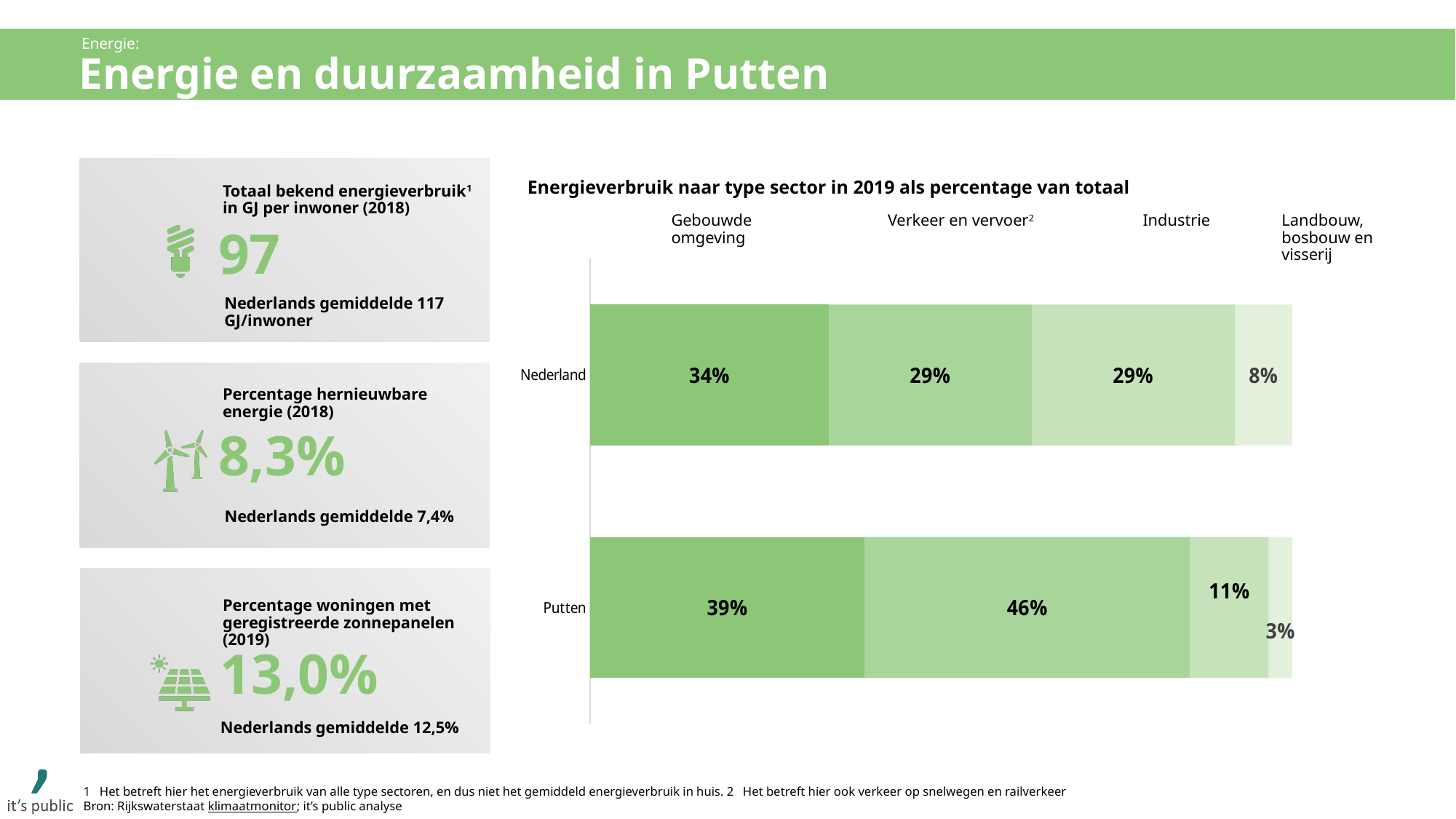
What is the value for Gebouwde omgeving for Putten? 39% What is the value for Verkeer en vervoer for Nederland? 29% How many sectors are shown in the chart? 4 Which sector has the largest share for Nederland? Gebouwde omgeving Which is larger: the Industrie share for Nederland or for Putten? Nederland Which sector has the smallest share for Putten? Landbouw, bosbouw en visserij How many bars (regions) are shown in the chart? 2 What is the difference between the Verkeer en vervoer share for Putten and for Nederland? 17 percentage points What is the value for Landbouw, bosbouw en visserij for Nederland? 8% What type of chart is shown on the slide? Stacked bar chart Which sector has the largest share for Putten? Verkeer en vervoer What is the value for Industrie for Putten? 11%